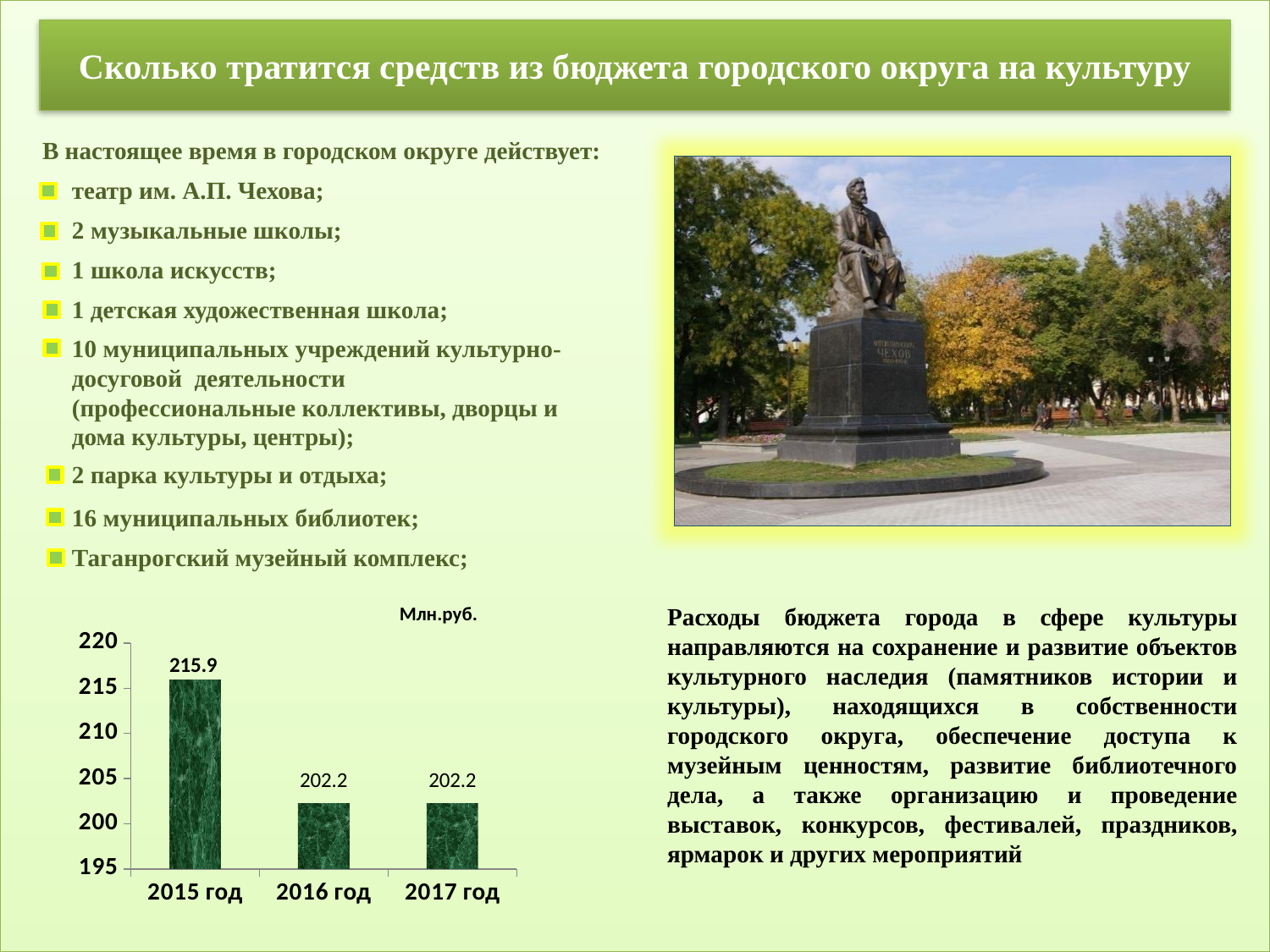
Which year has the highest value? 2015 год What kind of chart is shown on the slide? bar chart What is the value for 2016 год? 202.2 Do the values rise or fall from 2015 год to 2016 год? fall Is the value for 2016 год greater or less than 205? less What is the value for 2017 год? 202.2 Is the value for 2015 год greater or less than 210? greater What unit is shown above the chart? Млн.руб. What is the value for 2015 год? 215.9 What is the difference between the values for 2015 год and 2016 год? 13.7 How many years are shown on the chart? 3 Which is larger, the value for 2015 год or the value for 2017 год? 2015 год